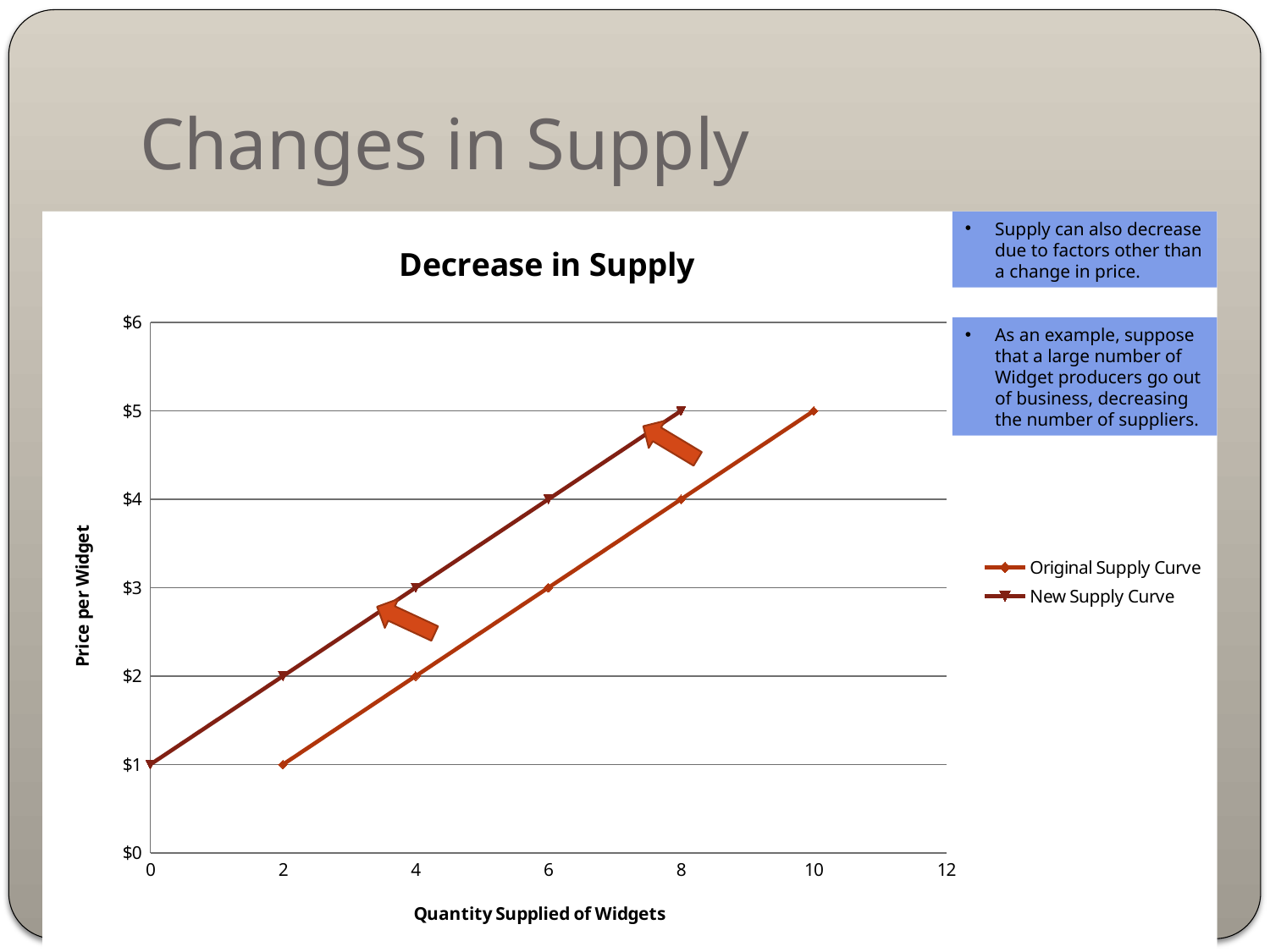
How many series does the chart legend list? 2 On the New Supply Curve, what is the price per widget when the quantity supplied is 8? $5 How many data points are plotted on the Original Supply Curve? 5 At a quantity of 4, which series shows the higher price: the Original Supply Curve or the New Supply Curve? New Supply Curve On the Original Supply Curve, what quantity is supplied at a price of $3? 6 On the New Supply Curve, what quantity is supplied at a price of $1? 0 What is the title of the chart? Decrease in Supply On the Original Supply Curve, what is the price per widget when the quantity supplied is 10? $5 Does the price on the Original Supply Curve rise or fall as quantity supplied increases? rise What is the label of the y axis? Price per Widget At a price of $4, what is the difference in quantity supplied between the Original Supply Curve and the New Supply Curve? 2 What kind of chart is shown on the slide? line chart